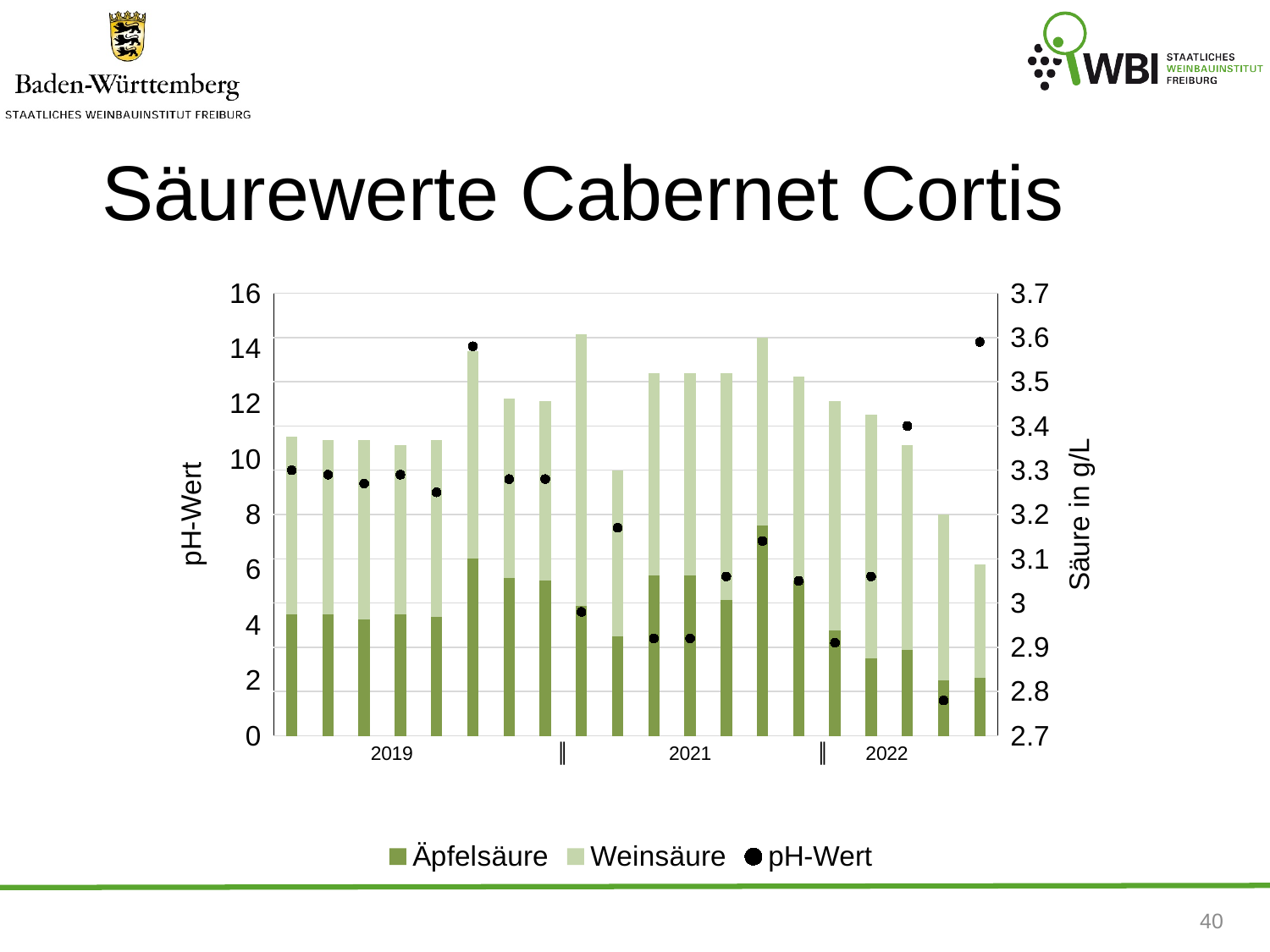
Is the total height of the leftmost bar (first bar of the 2019 group) greater or less than 10? greater Which bar has the lowest pH-Wert marker? the second-to-last bar (in the 2022 group) Which bar has the lowest total height? the rightmost bar (last bar of the 2022 group) Which is larger, the Äpfelsäure segment of the leftmost bar or the Äpfelsäure segment of the rightmost bar? the leftmost bar Is the total height of the rightmost bar (last bar of the 2022 group) greater or less than 8? less What are the three entries in the chart legend? Äpfelsäure, Weinsäure, pH-Wert What is the title of the chart? Säurewerte Cabernet Cortis What kind of chart is shown on the slide? stacked bar chart with a marker (pH-Wert) series Do the total bar heights rise or fall from left to right within the 2022 group? fall How many stacked bars are plotted in the chart? 20 How many series does the legend list? 3 How many year labels are shown on the x axis? 3